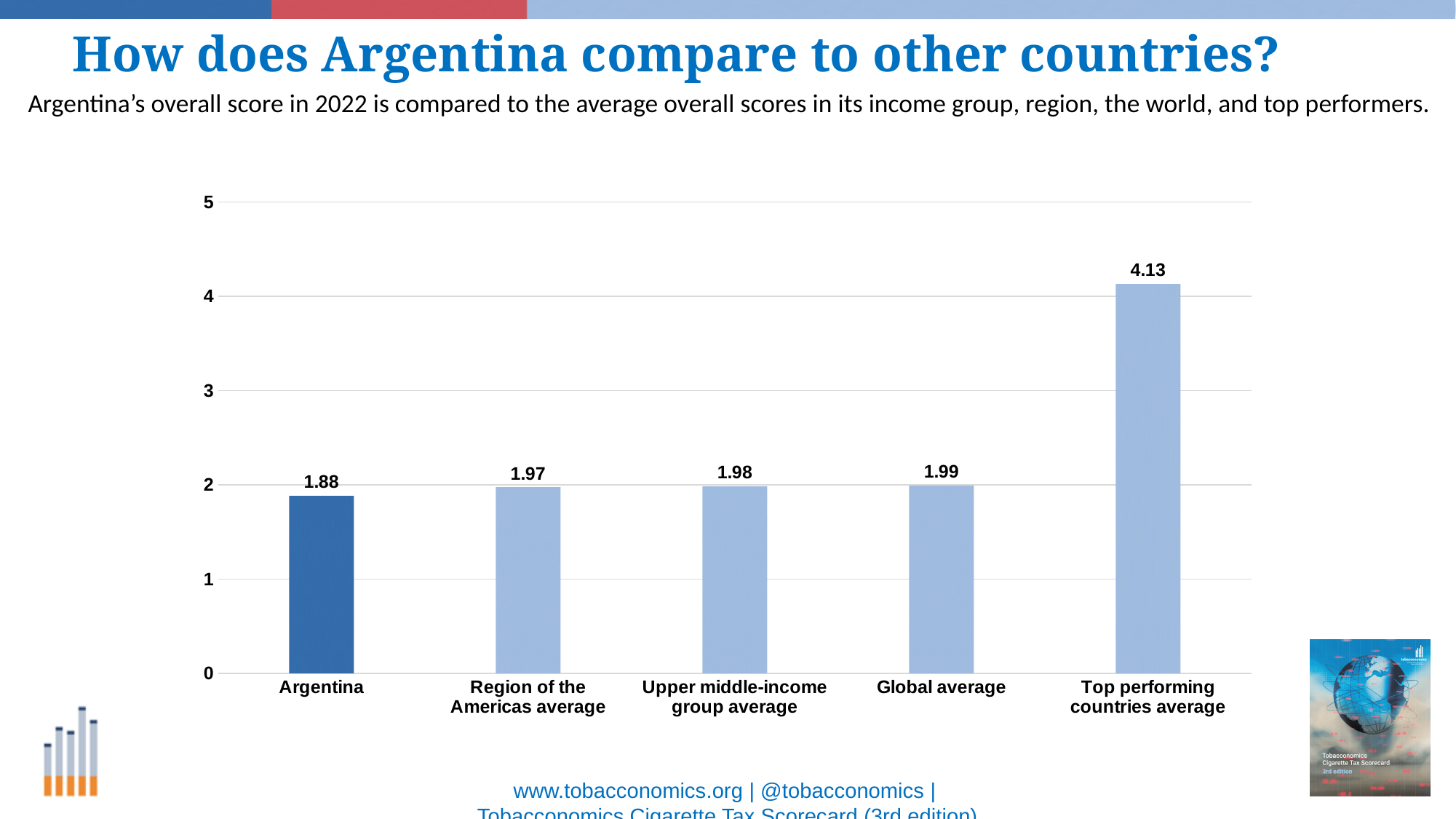
What kind of chart is shown on the slide? Bar chart Which category has the lowest value? Argentina What is the difference between the Top performing countries average and Argentina? 2.25 What is the value for Region of the Americas average? 1.97 Which is larger, the value for Argentina or the value for Top performing countries average? Top performing countries average What is the value for Global average? 1.99 Is the value for Top performing countries average greater or less than 4? greater Which category has the highest value? Top performing countries average What is the difference between the Global average and Argentina? 0.11 What is the value for Top performing countries average? 4.13 What is the value for Argentina? 1.88 How many categories are shown on the chart? 5